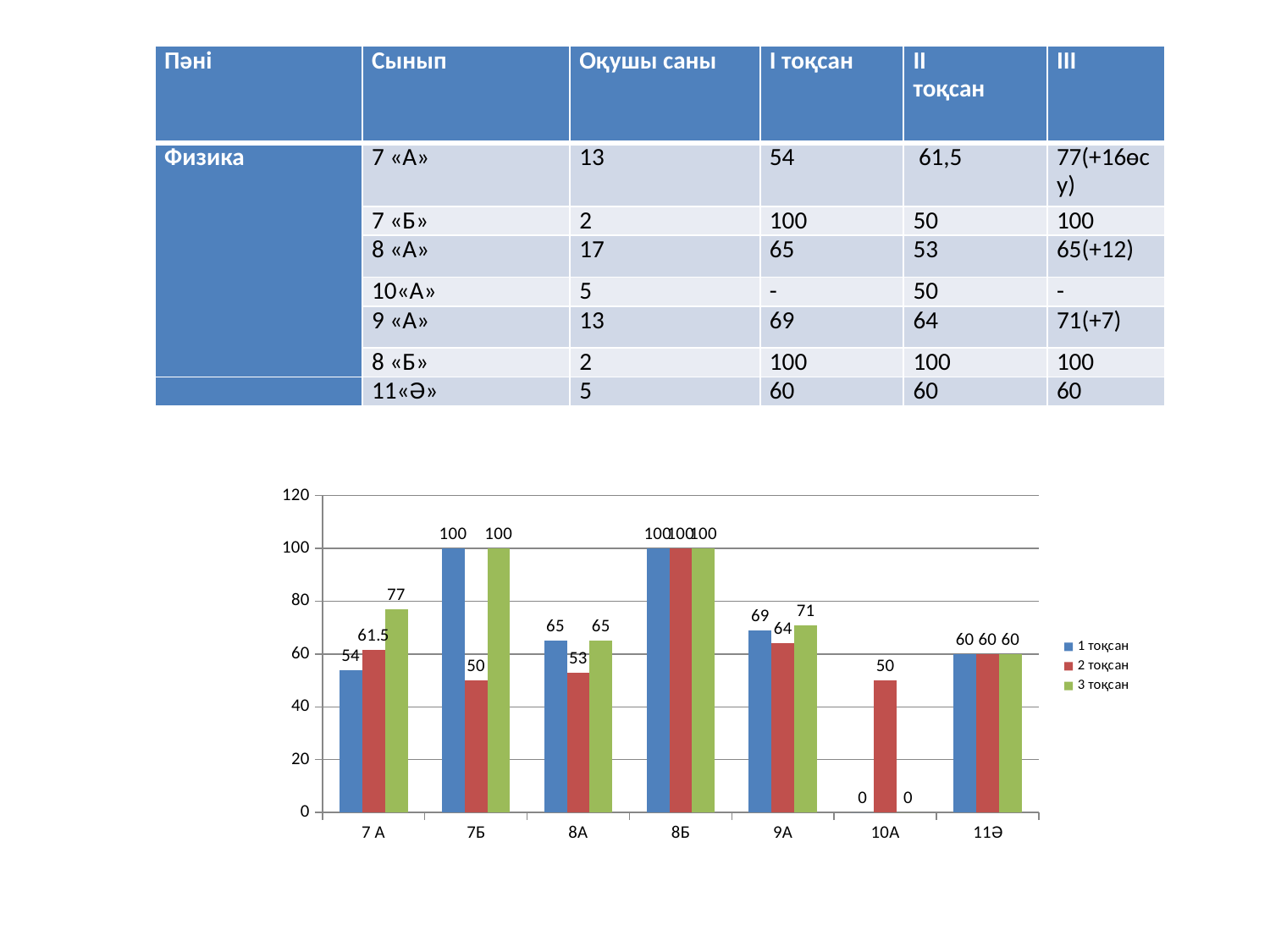
What type of chart is shown on the slide? bar chart How many class categories are shown on the x axis of the chart? 7 Which class has the lowest 1 тоқсан value in the chart? 10А Which is larger in the chart: the 1 тоқсан value for 8А or the 1 тоқсан value for 9А? 9А What is the value of 2 тоқсан for 7Б in the chart? 50 What is the value of 3 тоқсан for 7 А in the chart? 77 Which colour represents the 2 тоқсан series in the chart? red What is the value of 1 тоқсан for 9А in the chart? 69 What is the value of 2 тоқсан for 7 А in the chart? 61.5 Is the 2 тоқсан value for 8А greater or less than 60 in the chart? less What is the difference between the 3 тоқсан and 1 тоқсан values for 7 А in the chart? 23 How many series does the chart legend list? 3